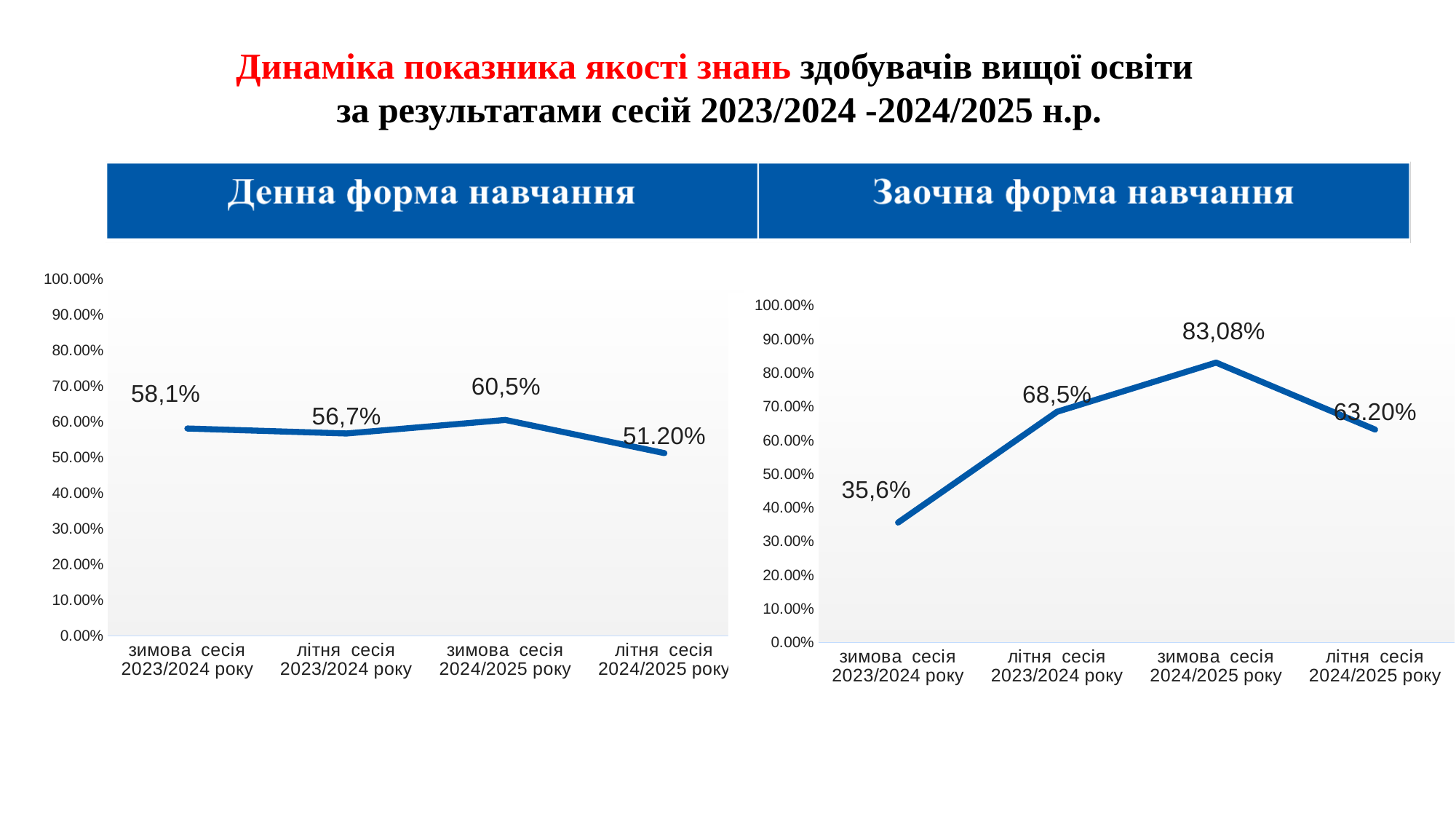
In the 'Заочна форма навчання' chart, what is the difference between the values for літня сесія 2023/2024 року and зимова сесія 2023/2024 року? 32,9% In the 'Денна форма навчання' chart, what is the value for зимова сесія 2023/2024 року? 58,1% In the 'Денна форма навчання' chart, which is larger: the value for зимова сесія 2023/2024 року or літня сесія 2023/2024 року? зимова сесія 2023/2024 року In the 'Заочна форма навчання' chart, does the value rise or fall from зимова сесія 2024/2025 року to літня сесія 2024/2025 року? fall In the 'Денна форма навчання' chart, what is the value for літня сесія 2024/2025 року? 51.20% How many sessions are plotted in the 'Денна форма навчання' chart? 4 In the 'Заочна форма навчання' chart, which session has the lowest value? зимова сесія 2023/2024 року In the 'Заочна форма навчання' chart, what is the value for зимова сесія 2023/2024 року? 35,6% In the 'Заочна форма навчання' chart, is the value for літня сесія 2024/2025 року greater or less than 60.00%? greater What type of chart is used for 'Заочна форма навчання'? line chart In the 'Заочна форма навчання' chart, what is the value for зимова сесія 2024/2025 року? 83,08% In the 'Денна форма навчання' chart, which session has the highest value? зимова сесія 2024/2025 року